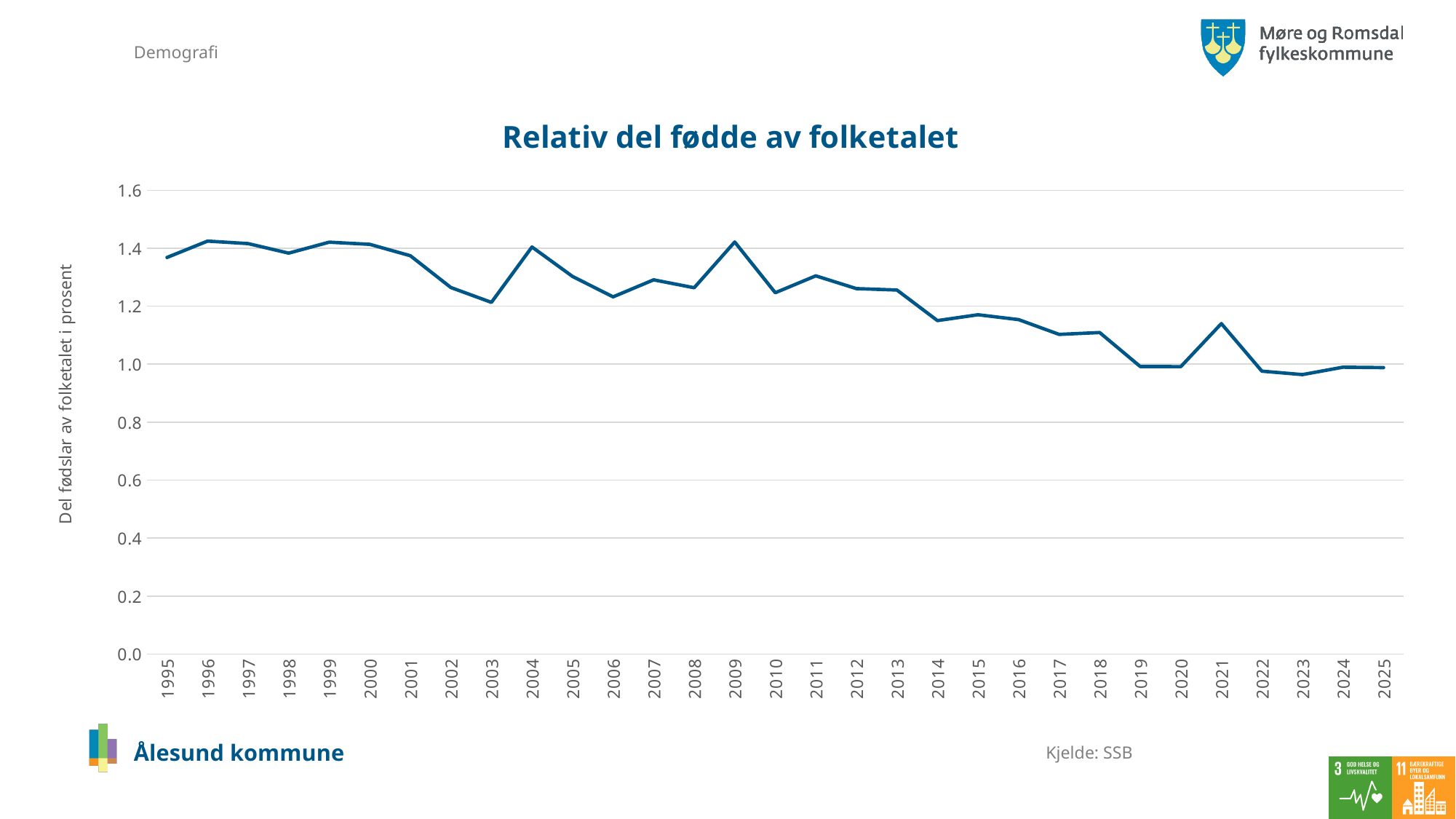
Which year has the larger value, 2009 or 2010? 2009 Is the value for 2003 greater or less than 1.4? less Which year has the larger value, 1995 or 2025? 1995 Is the value for 2019 greater or less than 1.2? less Overall, do the values rise or fall from 1995 to 2025? fall What is the title of the chart? Relativ del fødde av folketalet How many years are plotted along the x axis of the chart? 31 What kind of chart is shown on the slide? line chart What is the label on the y axis of the chart? Del fødslar av folketalet i prosent Which year has the larger value, 2003 or 2004? 2004 Is the value for 2021 greater or less than 1.0? greater